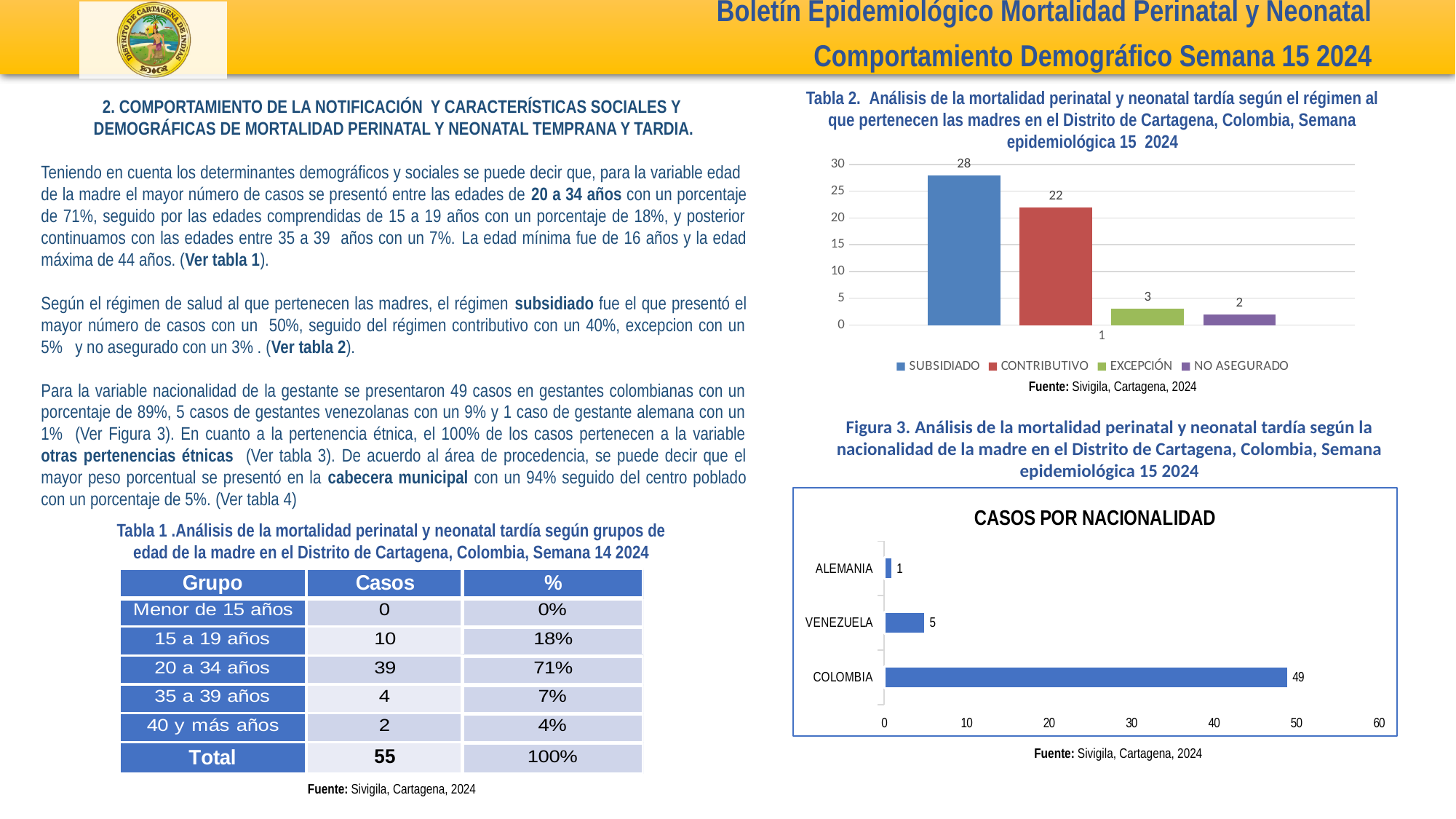
In the chart titled 'Tabla 2' (régimen al que pertenecen las madres), which category has the lowest value? NO ASEGURADO What kind of chart is the one titled 'CASOS POR NACIONALIDAD'? Bar chart In the chart titled 'CASOS POR NACIONALIDAD', what is the value for COLOMBIA? 49 In the chart titled 'Tabla 2' (régimen al que pertenecen las madres), what is the value for CONTRIBUTIVO? 22 In the chart titled 'CASOS POR NACIONALIDAD', what is the value for VENEZUELA? 5 In the chart titled 'Tabla 2' (régimen al que pertenecen las madres), what is the difference between SUBSIDIADO and CONTRIBUTIVO? 6 In the chart titled 'CASOS POR NACIONALIDAD', which category has the highest value? COLOMBIA In the chart titled 'CASOS POR NACIONALIDAD', how many categories are shown? 3 In the chart titled 'CASOS POR NACIONALIDAD', what is the difference between COLOMBIA and VENEZUELA? 44 In the chart titled 'Tabla 2' (régimen al que pertenecen las madres), what colour is the CONTRIBUTIVO bar? Red In the chart titled 'Tabla 2' (régimen al que pertenecen las madres), what is the value for SUBSIDIADO? 28 In the chart titled 'Tabla 2' (régimen al que pertenecen las madres), how many series does the legend list? 4